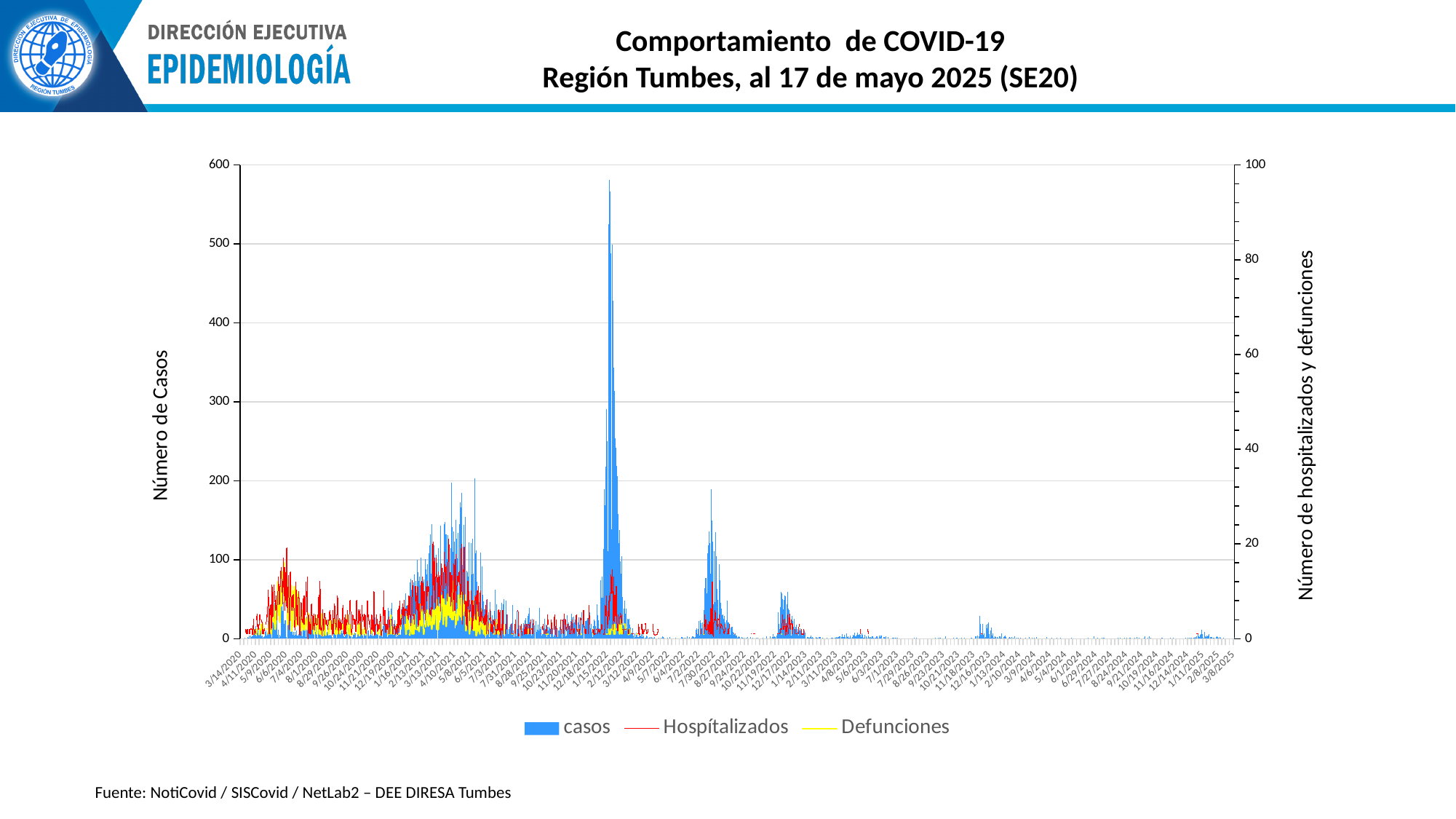
Is the highest value of Hospitalizados on the right axis greater or less than 40? less Is the highest daily value of casos greater or less than 500? greater What kind of chart is shown on the slide? Combined bar and line chart What is the last date label on the x axis? 3/8/2025 Is the highest value of Defunciones on the right axis greater or less than 40? less What is the maximum tick value on the left vertical axis? 600 What is the maximum tick value on the right vertical axis? 100 Which series is plotted as blue bars? casos What is the title of the chart on the slide? Comportamiento de COVID-19 Región Tumbes, al 17 de mayo 2025 (SE20) How many series does the legend list? 3 What is the first date label on the x axis? 3/14/2020